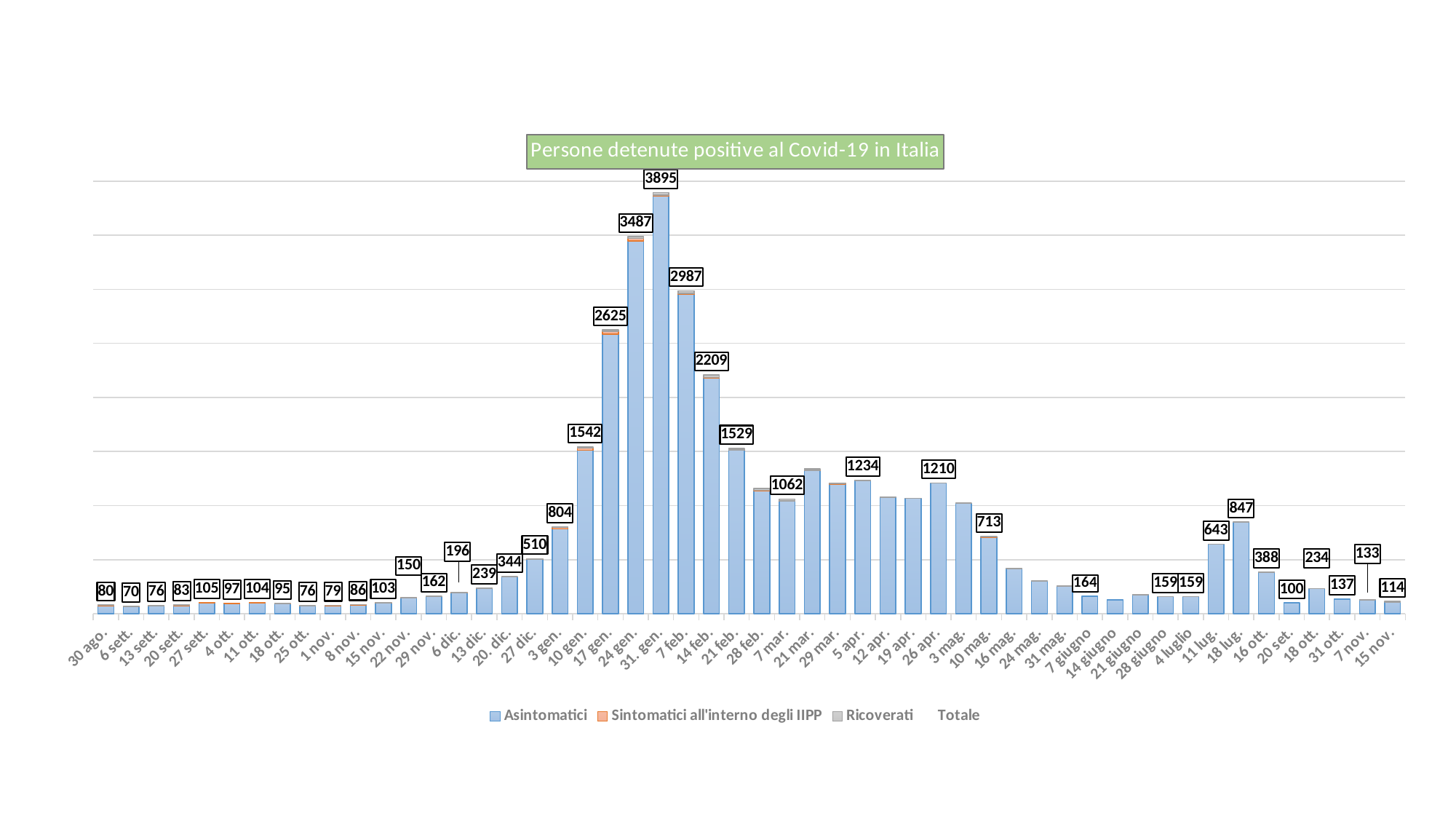
How many series does the legend list? 4 Which date has the highest total? 31 gen. What is the difference between the totals for 31 gen. and 24 gen.? 408 What is the total value labelled for 31 gen.? 3895 What is the difference between the totals for 7 feb. and 14 feb.? 778 Which is larger, the total for 17 gen. or the total for 7 feb.? 7 feb. What is the title of the chart? Persone detenute positive al Covid-19 in Italia What is the total value labelled for 24 gen.? 3487 Do the totals rise or fall from 31 gen. to 21 feb.? fall What is the total value labelled for 18 lug.? 847 What is the total value labelled for 3 gen.? 804 What kind of chart is shown on the slide? bar chart